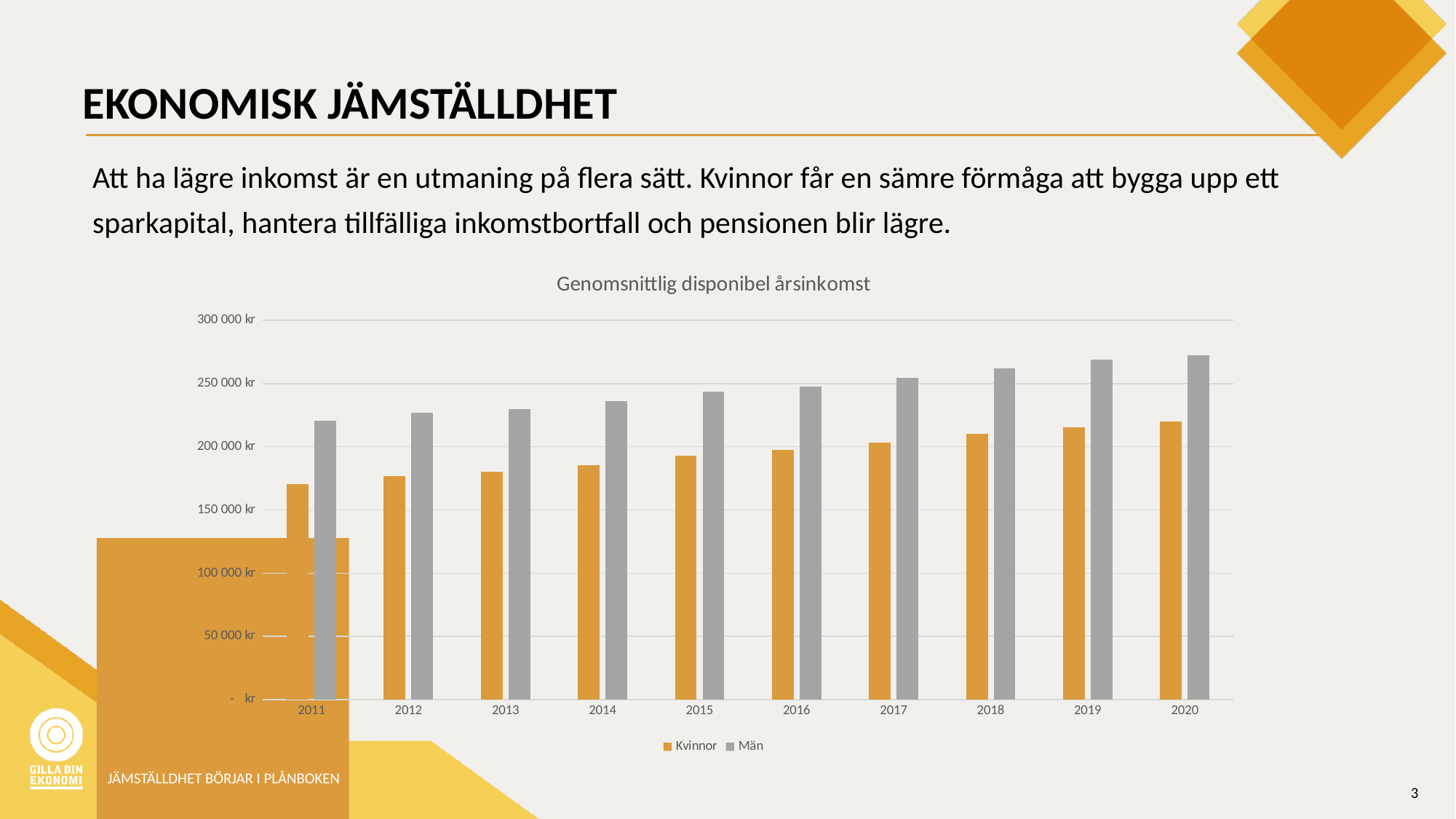
In 2015, which is larger: the value for Kvinnor or the value for Män? Män What is the title of the chart? Genomsnittlig disponibel årsinkomst What kind of chart is shown on the slide? bar chart Which colour represents the Män series in the chart? grey Is the value for Män in 2020 greater or less than 250 000 kr? greater Which year has the highest value for Män? 2020 Which year has the lowest value for Kvinnor? 2011 How many years are shown on the x axis of the chart? 10 Is the value for Kvinnor in 2011 greater or less than 150 000 kr? greater Is the value for Män in 2011 greater or less than 250 000 kr? less How many series does the chart's legend list? 2 Do the values for Kvinnor rise or fall from 2011 to 2020? rise